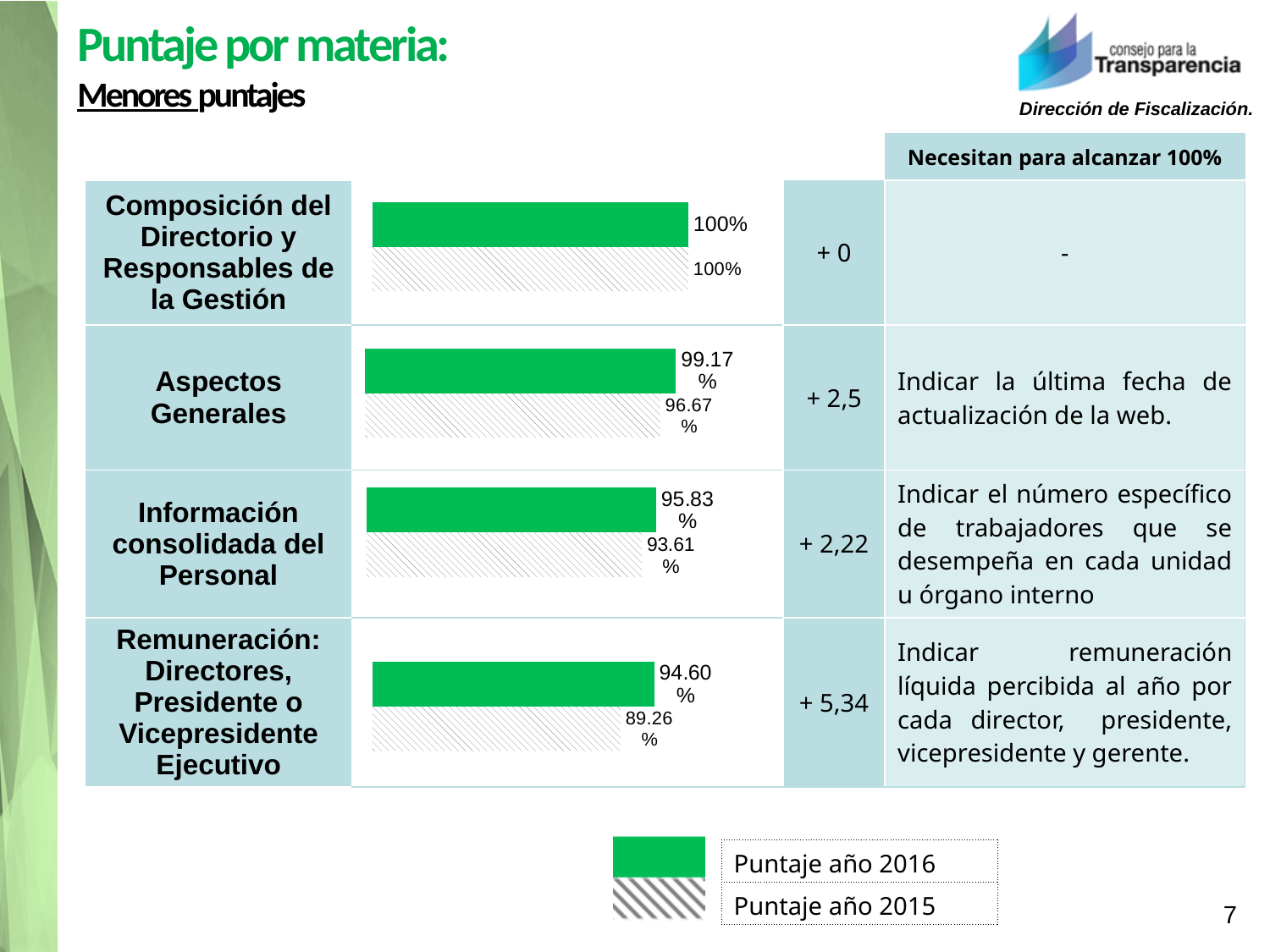
In the chart for Información consolidada del Personal, what is the value for Puntaje año 2016? 95.83 % In the chart for Remuneración: Directores, Presidente o Vicepresidente Ejecutivo, what is the difference between the Puntaje año 2016 and Puntaje año 2015 values? 5.34 In the chart for Aspectos Generales, what is the value for Puntaje año 2016? 99.17 % In the chart for Aspectos Generales, what is the value for Puntaje año 2015? 96.67 % In the chart for Aspectos Generales, what is the difference between the Puntaje año 2016 and Puntaje año 2015 values? 2.50 How many series does the legend at the bottom of the slide list? 2 In the chart for Remuneración: Directores, Presidente o Vicepresidente Ejecutivo, what is the value for Puntaje año 2015? 89.26 % In the chart for Composición del Directorio y Responsables de la Gestión, what is the value for Puntaje año 2016? 100% Which series is shown with the hatched pattern in the legend? Puntaje año 2015 In the chart for Información consolidada del Personal, what is the value for Puntaje año 2015? 93.61 % What kind of chart is used in the Aspectos Generales row? Bar chart In the chart for Información consolidada del Personal, which is larger, Puntaje año 2016 or Puntaje año 2015? Puntaje año 2016